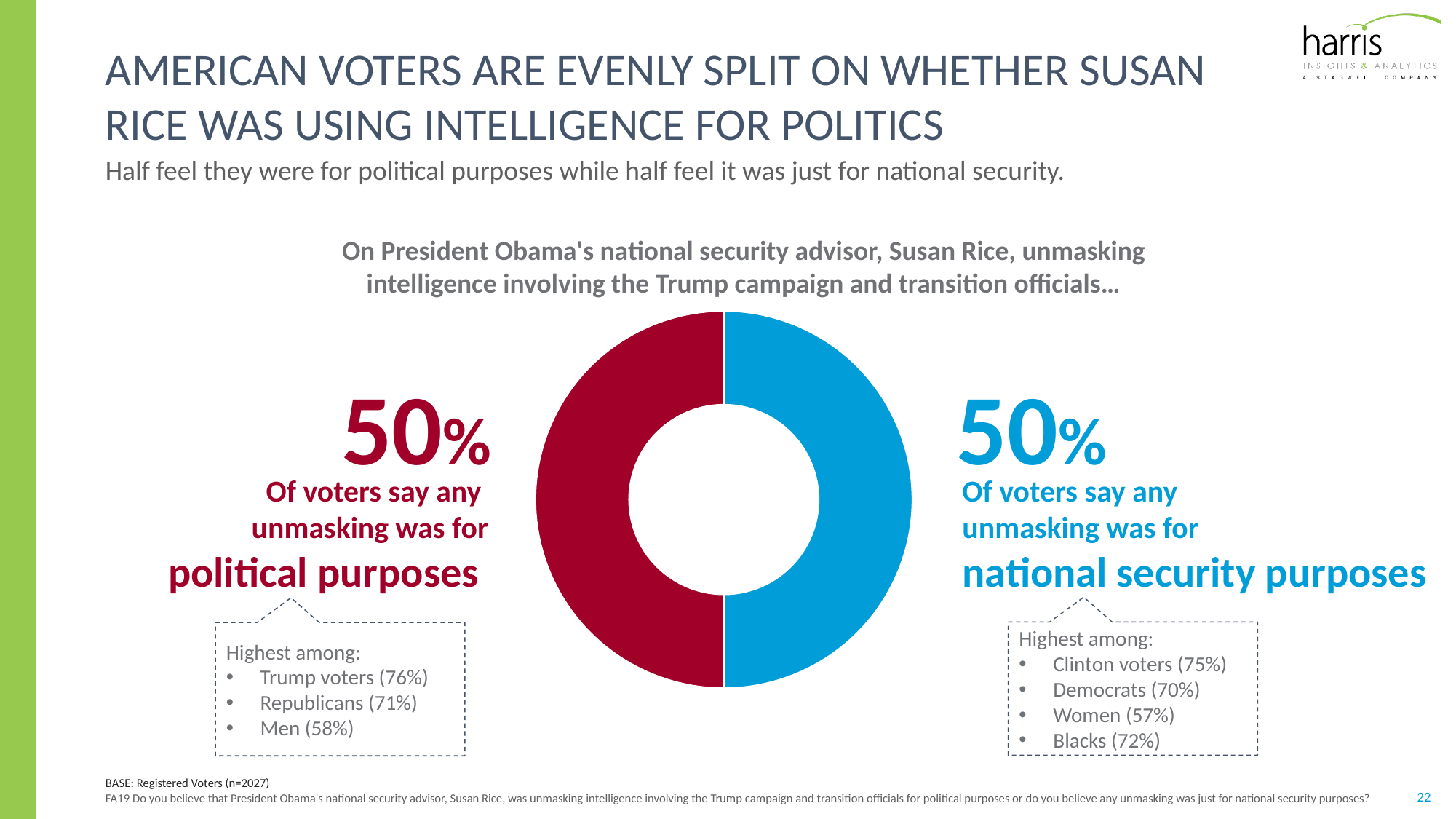
What is the base sample size shown for the chart? n=2027 What percentage of voters say any unmasking was for national security purposes? 50% What is the difference between the share saying political purposes and the share saying national security purposes? 0 How many slices does the donut chart have? 2 Among which group is the 'political purposes' response highest, according to the callout? Trump voters (76%) What kind of chart is shown on the slide? Pie chart (donut) What share of the pie does the 'political purposes' slice represent? 50% Which colour represents voters who say unmasking was for national security purposes? Blue Which colour represents voters who say unmasking was for political purposes? Red What percentage of Clinton voters say unmasking was for national security purposes? 75% What percentage of Republicans say unmasking was for political purposes? 71% What percentage of voters say any unmasking was for political purposes? 50%